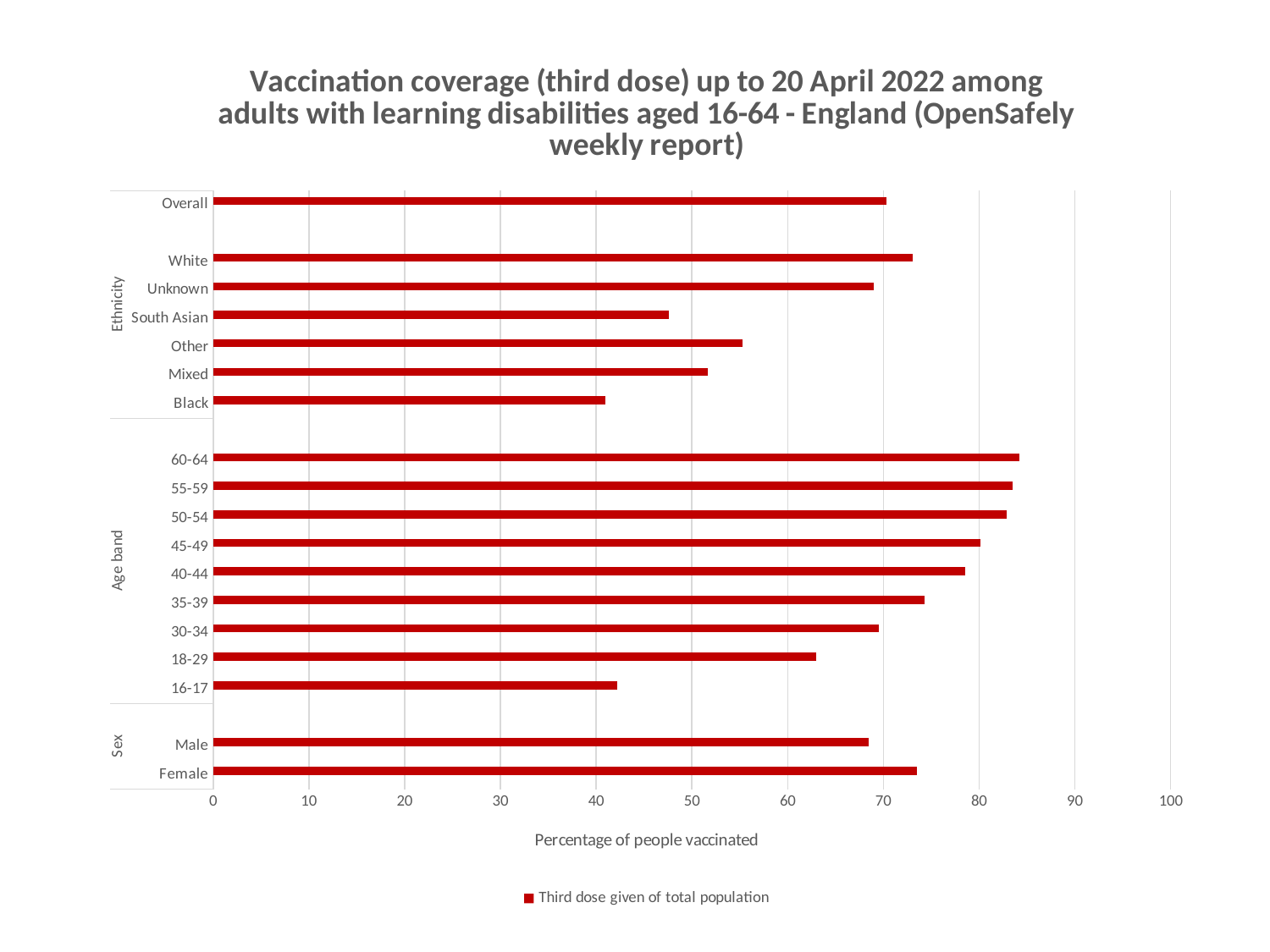
Among the Ethnicity categories, which has the lowest vaccination coverage? Black What is the legend entry for the series shown in the chart? Third dose given of total population Which has the larger value, Female or Male? Female How many series does the legend list? 1 Is the value for 60-64 greater or less than 80? greater Do the values generally rise or fall as the age band increases from 16-17 to 60-64? rise How many bars (categories) are plotted in the chart? 18 Is the value for Black greater or less than 50? less Is the value for 16-17 greater or less than 50? less Among the Ethnicity categories, which has the highest vaccination coverage? White What is the label of the horizontal axis? Percentage of people vaccinated What kind of chart is shown on the slide? Bar chart